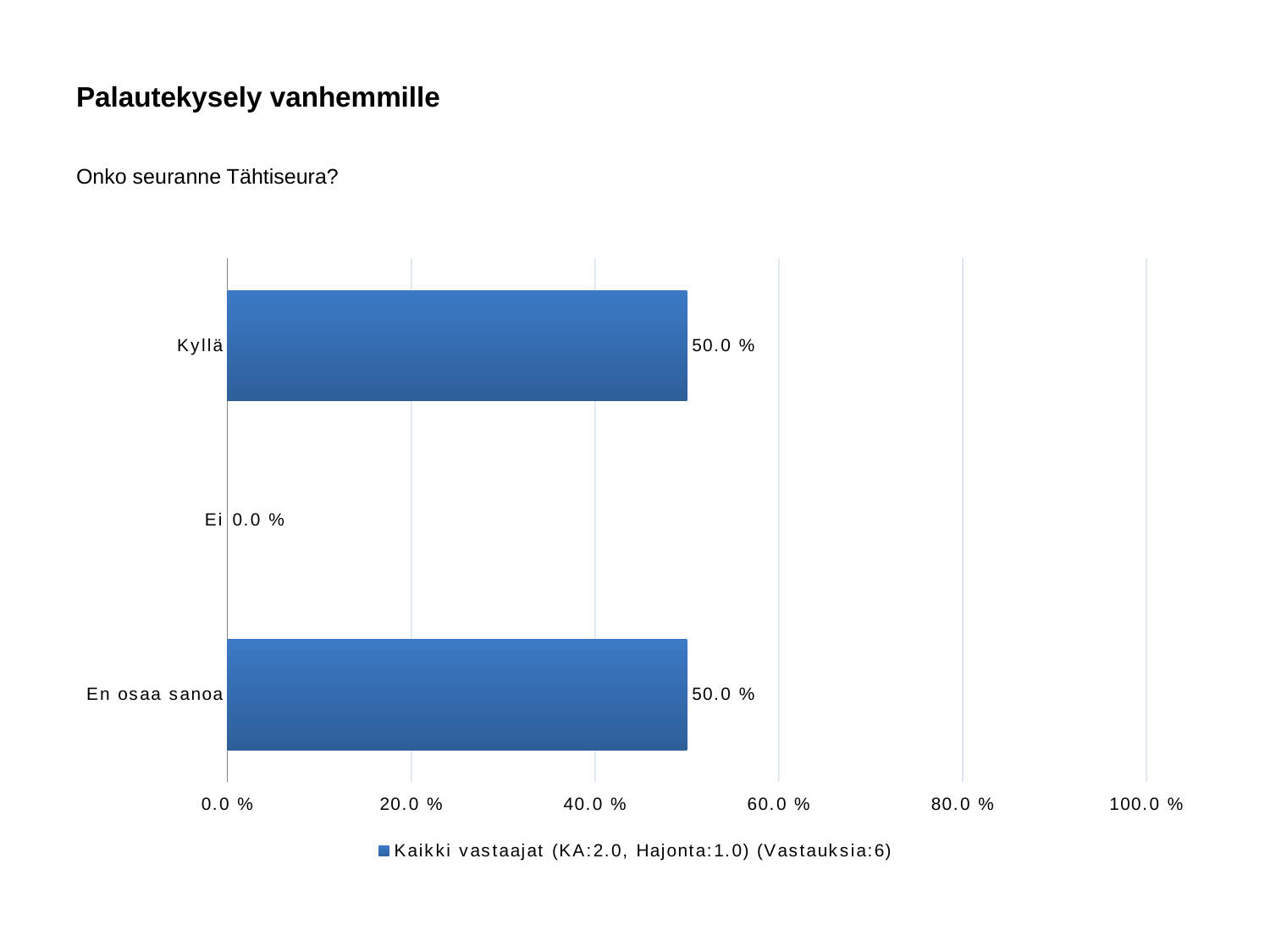
How many categories are shown in the chart? 3 What is the difference between the values for Kyllä and Ei? 50.0 % Is the value for Kyllä greater or less than 40.0 %? greater What is the value for Ei? 0.0 % What is the value for En osaa sanoa? 50.0 % Which is larger, the value for Kyllä or the value for Ei? Kyllä Which category has the lowest value? Ei How many series does the legend list? 1 Is the value for En osaa sanoa greater or less than 60.0 %? less What question does the chart answer, as shown above it? Onko seuranne Tähtiseura? What is the value for Kyllä? 50.0 % What kind of chart is shown? bar chart